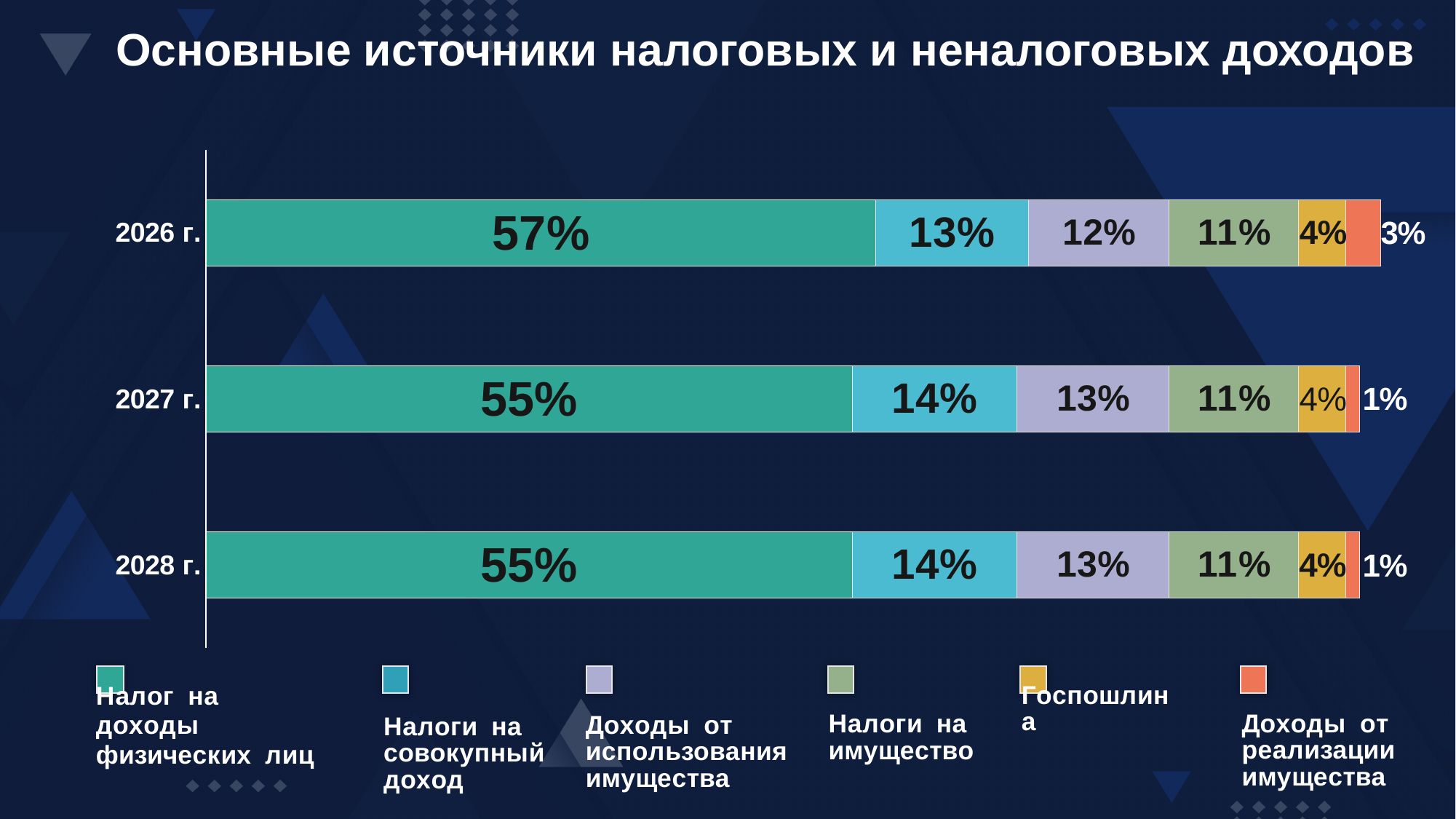
What is the title of the chart? Основные источники налоговых и неналоговых доходов What is the difference between the Налог на доходы физических лиц values for 2026 г. and 2027 г.? 2 percentage points In which year is the share of Налог на доходы физических лиц the highest? 2026 г. Does the share of Доходы от реализации имущества rise or fall from 2026 г. to 2028 г.? Fall How many series does the legend list? 6 What is the value for Госпошлина in 2028 г.? 4% How many years are shown on the chart? 3 What kind of chart is shown on the slide? Stacked bar chart What is the value for Доходы от реализации имущества in 2026 г.? 3% In 2026 г., which is larger: Налоги на совокупный доход or Доходы от использования имущества? Налоги на совокупный доход What is the value for Налоги на совокупный доход in 2027 г.? 14% What is the value for Налог на доходы физических лиц in 2026 г.? 57%